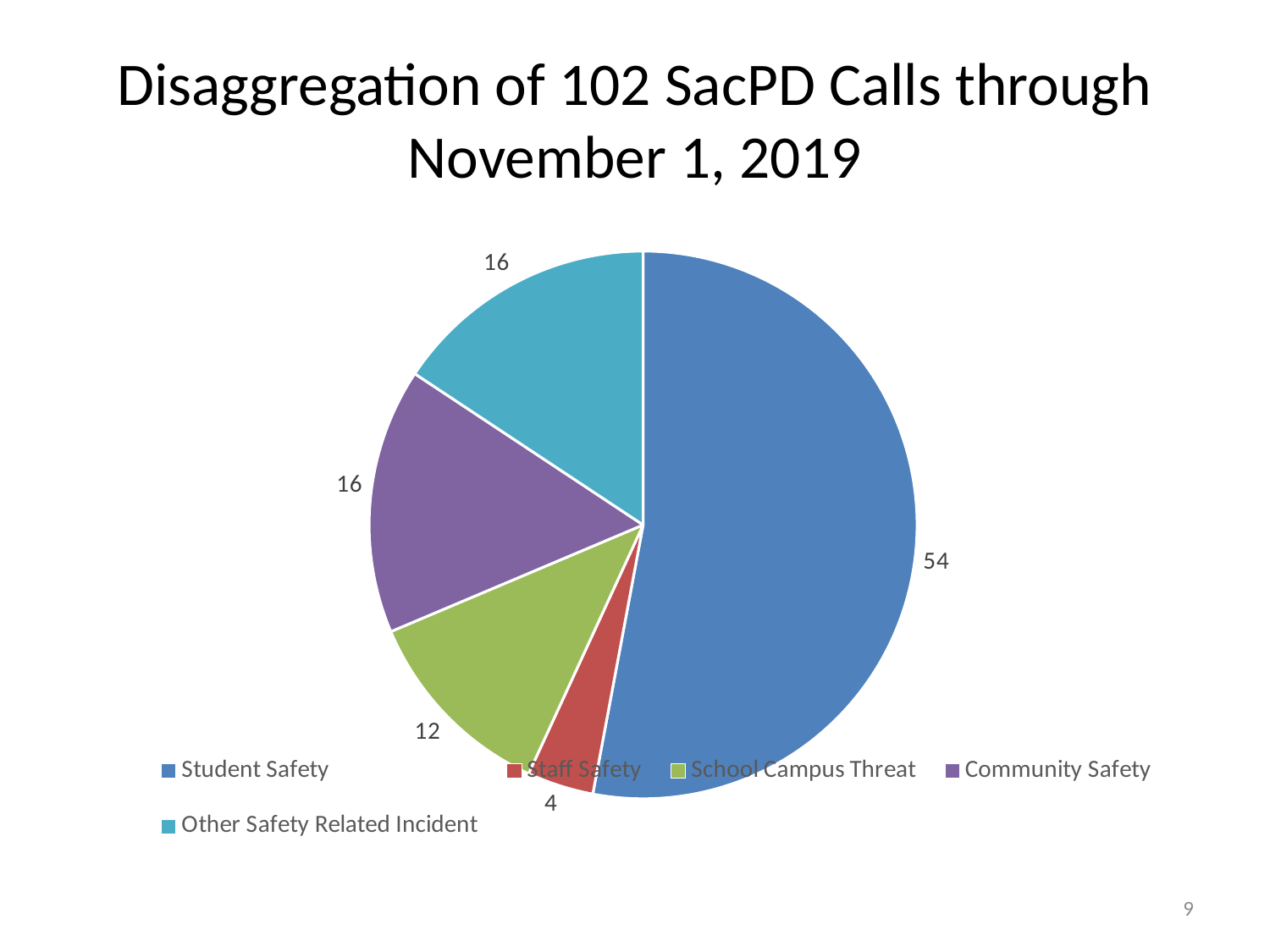
How many calls are attributed to School Campus Threat? 12 Which has more calls, School Campus Threat or Other Safety Related Incident? Other Safety Related Incident What is the difference between the Student Safety and Community Safety call counts? 38 Which category has the smallest number of calls? Staff Safety How many calls are attributed to Community Safety? 16 What is the difference between the School Campus Threat and Staff Safety call counts? 8 Which category has the largest number of calls? Student Safety How many categories does the pie chart show? 5 What type of chart is shown on the slide? pie chart How many calls are attributed to Staff Safety? 4 What is the title of the chart? Disaggregation of 102 SacPD Calls through November 1, 2019 How many calls are attributed to Student Safety? 54